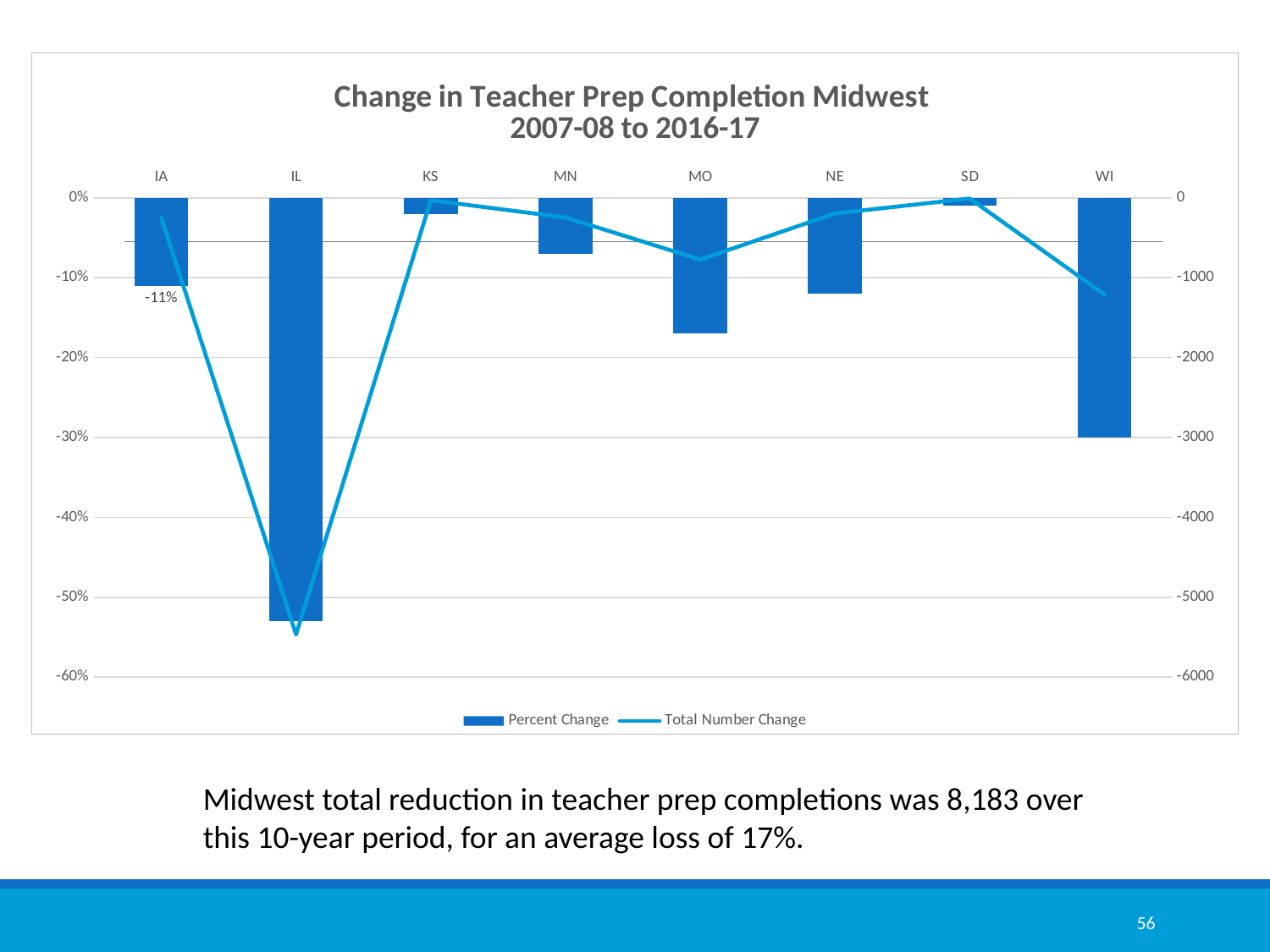
How many series does the chart legend list? 2 Which state has the largest decline in Total Number Change (the lowest point on the line)? IL Which series is plotted as a line rather than bars? Total Number Change What is the percent change in teacher prep completion shown for IA? -11% Is the Total Number Change value for WI greater or less than -1000? less Which state shows the largest percentage decline (the longest Percent Change bar)? IL Which state has the larger percentage decline, WI or NE? WI Which state has the larger percentage decline, MO or MN? MO What kind of chart is this? Combination bar and line chart Is the Percent Change value for WI greater or less than -20%? less Is the Percent Change value for IL greater or less than -50%? less How many states are shown on the x axis of the chart? 8